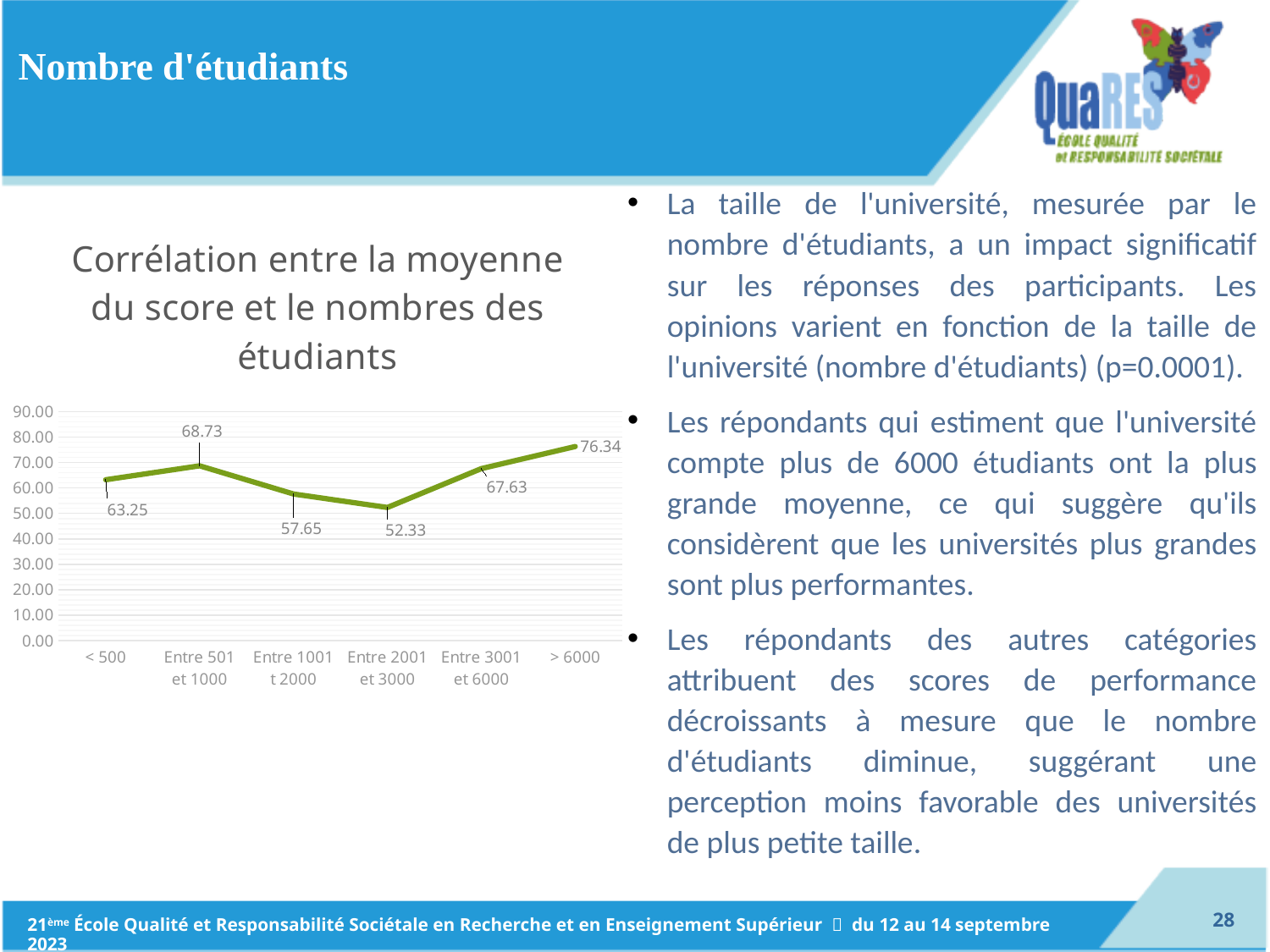
What is the value for the "Entre 2001 et 3000" category? 52.33 Which category has the lowest value? Entre 2001 et 3000 Which is larger, the value for "Entre 501 et 1000" or the value for "Entre 3001 et 6000"? Entre 501 et 1000 What is the difference between the values for "> 6000" and "Entre 2001 et 3000"? 24.01 How many categories are shown on the x axis? 6 What is the value for the "< 500" category? 63.25 Which category has the highest value? > 6000 What is the title of the chart? Corrélation entre la moyenne du score et le nombres des étudiants What is the value for the "Entre 501 et 1000" category? 68.73 What kind of chart is shown on the slide? line chart What is the value for the "> 6000" category? 76.34 Is the value for "Entre 1001 t 2000" greater or less than 60.00? less